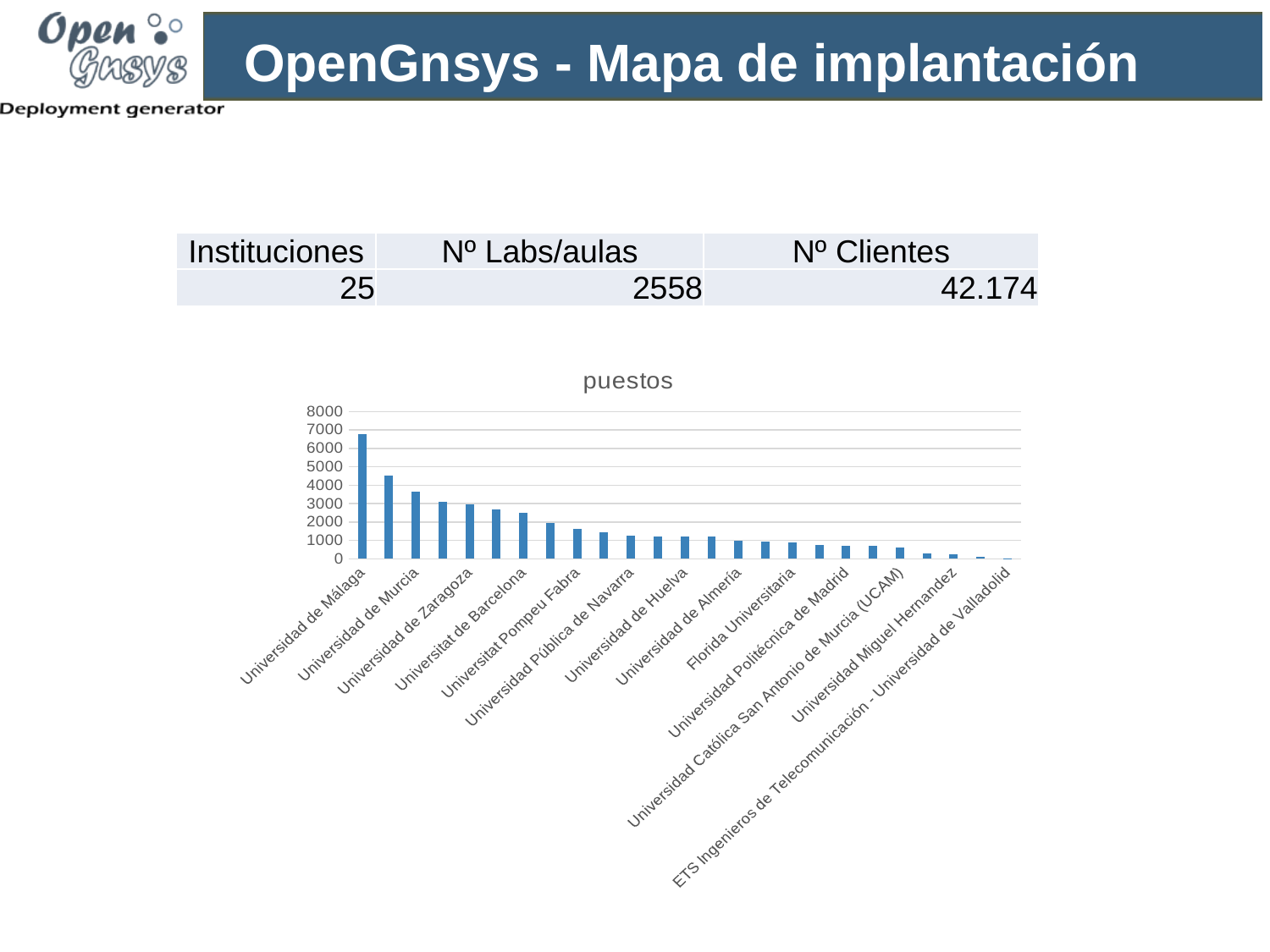
Is the value for Universidad de Murcia greater or less than 4000? less Do the values in the puestos chart rise or fall from left to right? fall Is the value for Universidad Politécnica de Madrid greater or less than 1000? less Is the value for Universidad de Málaga greater or less than 6000? greater What is the title of the chart? puestos Which has a larger value, Universidad de Málaga or Universidad de Murcia? Universidad de Málaga Which labelled institution has the lowest value in the puestos chart? ETS Ingenieros de Telecomunicación - Universidad de Valladolid Which has a larger value, Universidad Pública de Navarra or Universidad Miguel Hernandez? Universidad Pública de Navarra What kind of chart is shown on the slide? bar chart Which institution has the highest value in the puestos chart? Universidad de Málaga